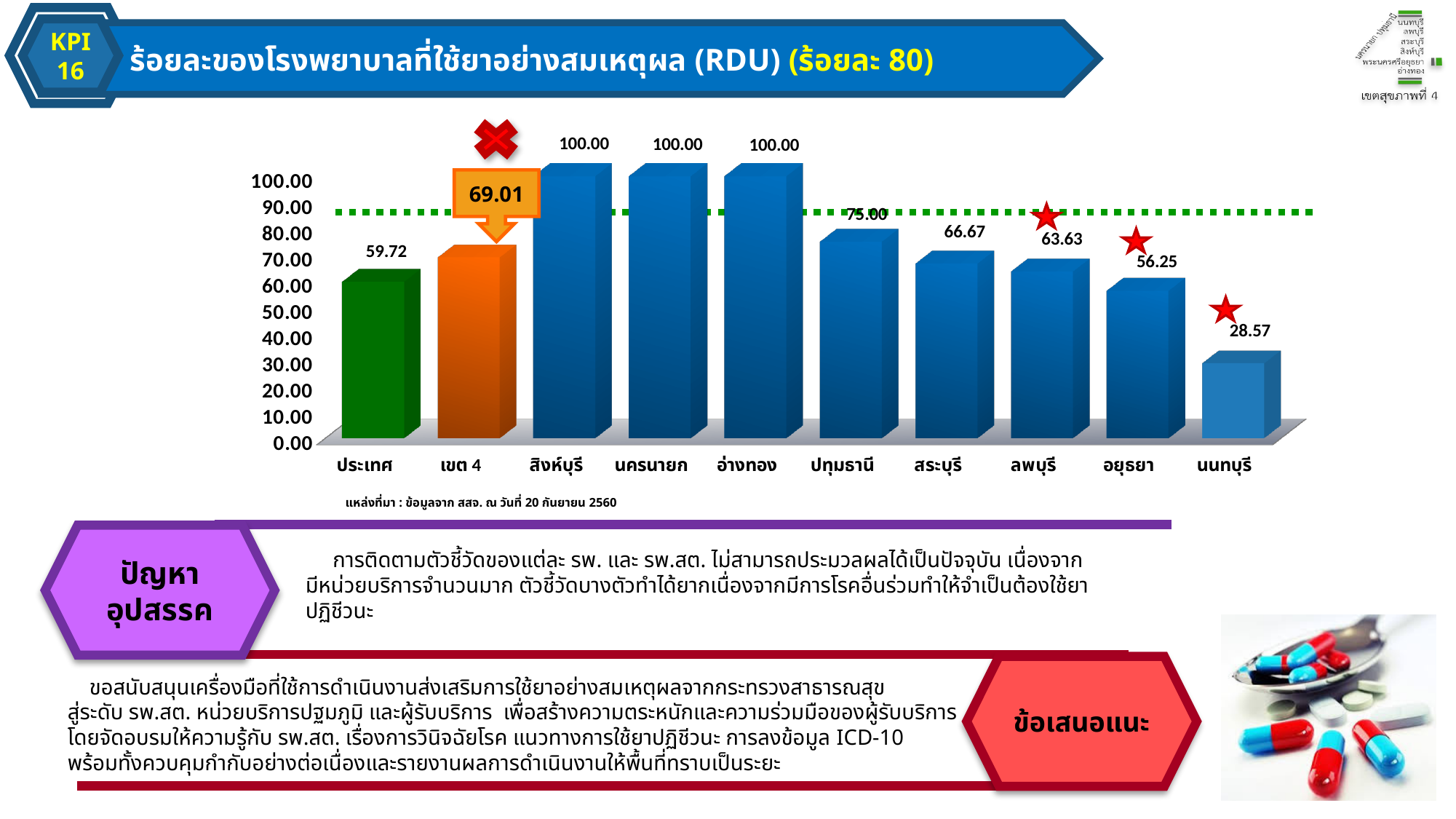
What kind of chart is shown on the slide? bar chart Is the value for นนทบุรี greater or less than 30.00? less What is the value for ปทุมธานี? 75.00 Which is larger, the value for อยุธยา or the value for ลพบุรี? ลพบุรี How many categories are shown on the x axis? 10 What is the value for เขต 4? 69.01 Which category has the lowest value? นนทบุรี What is the value for ประเทศ? 59.72 What is the value for นนทบุรี? 28.57 How many categories have a value of 100.00? 3 What is the difference between the values for เขต 4 and ประเทศ? 9.29 What is the difference between the values for สระบุรี and ลพบุรี? 3.04